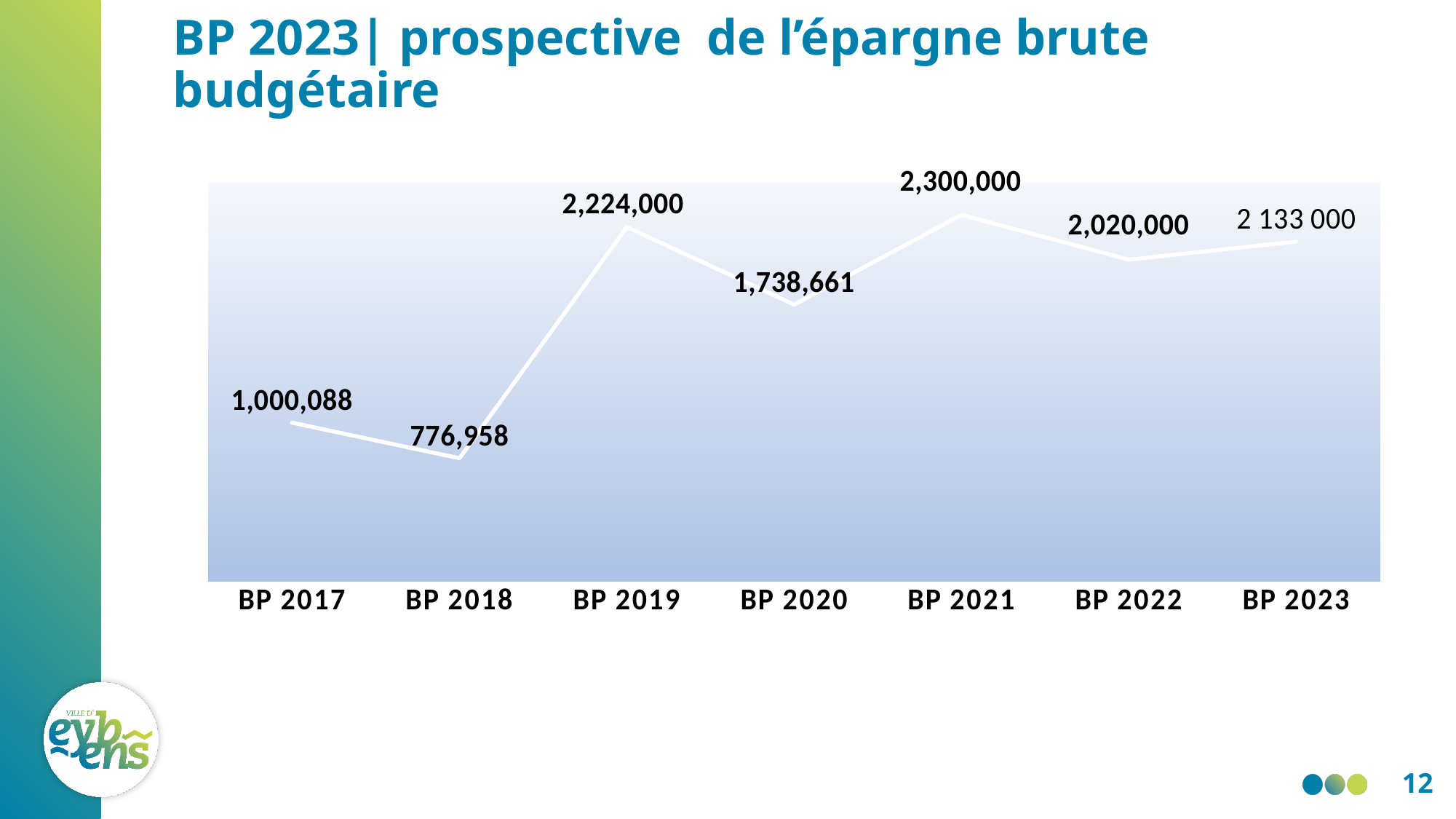
What is the difference between the values for BP 2021 and BP 2019? 76,000 What is the value for BP 2020? 1,738,661 What is the difference between the values for BP 2017 and BP 2018? 223,130 What is the value for BP 2023? 2 133 000 Which is larger, the value for BP 2022 or the value for BP 2020? BP 2022 What kind of chart is shown on the slide? line chart Which year has the lowest value? BP 2018 Which year has the highest value? BP 2021 What is the value for BP 2019? 2,224,000 How many years are plotted on the chart? 7 What is the value for BP 2018? 776,958 Does the value rise or fall from BP 2021 to BP 2022? fall